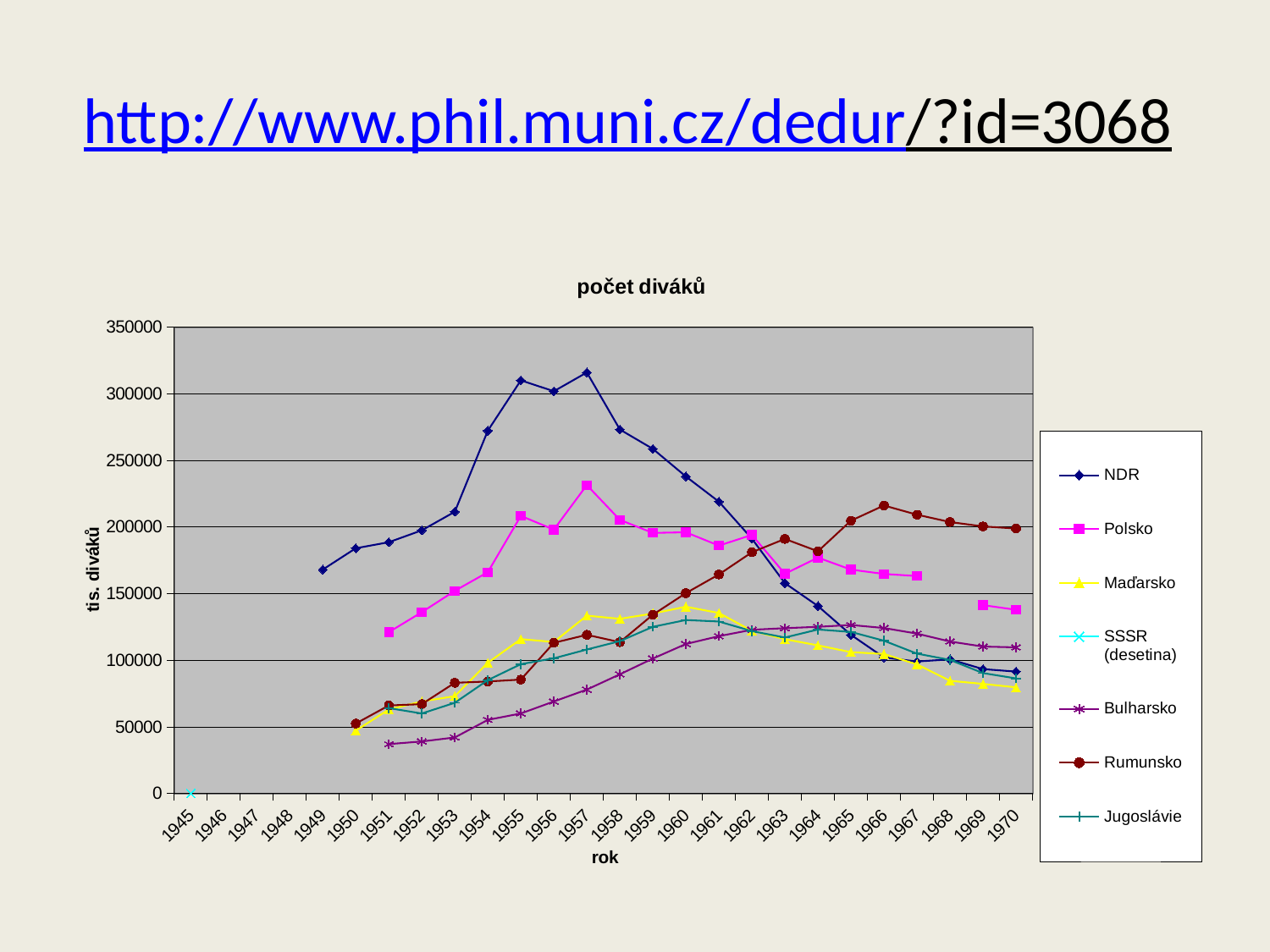
In 1955, which series has the larger value, NDR or Polsko? NDR Is the value for NDR in 1957 greater or less than 300000? greater How many series does the legend of the chart list? 7 Is the value for Bulharsko in 1951 greater or less than 50000? less Do the values for NDR rise or fall from 1957 to 1970? fall Which series reaches the highest value anywhere on the chart? NDR What is the label of the x axis of the chart? rok Is the value for Rumunsko in 1966 greater or less than 200000? greater What kind of chart is shown on the slide? line chart In 1970, which series has the larger value, Rumunsko or NDR? Rumunsko What is the title of the chart? počet diváků